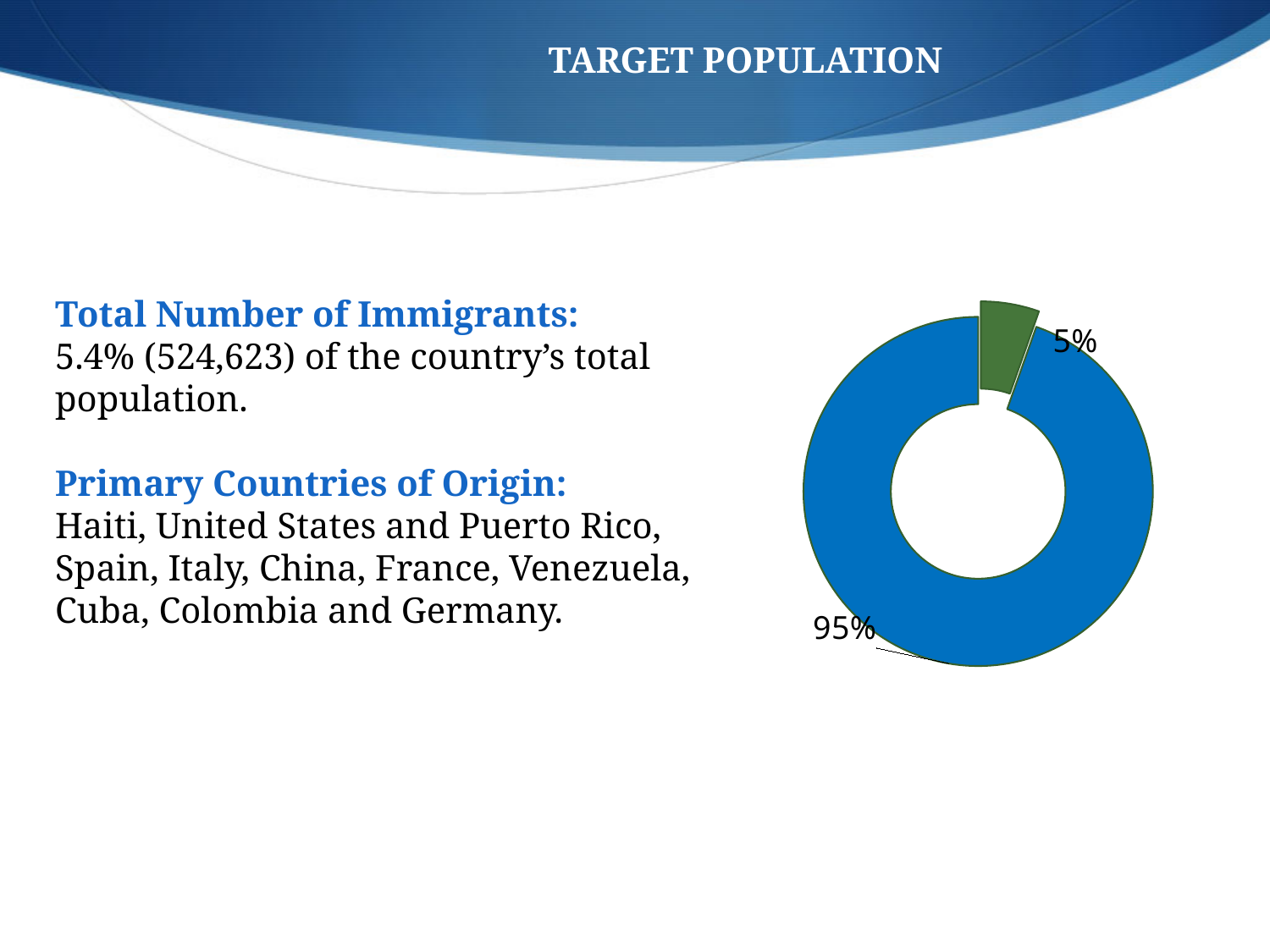
What share of the doughnut chart does the blue slice represent? 95% How many slices does the doughnut chart have? 2 Is the share of the green slice greater or less than 50%? less What is the difference in percentage points between the blue slice and the green slice? 90 Which slice of the doughnut chart is the smallest? The green slice (5%) Does the doughnut chart have a legend? No What colour is the slice labelled 5%? Green What share of the doughnut chart does the green slice represent? 5% Which slice of the doughnut chart is the largest? The blue slice (95%) What kind of chart is shown on the slide? Doughnut chart Which is larger, the blue slice or the green slice? The blue slice